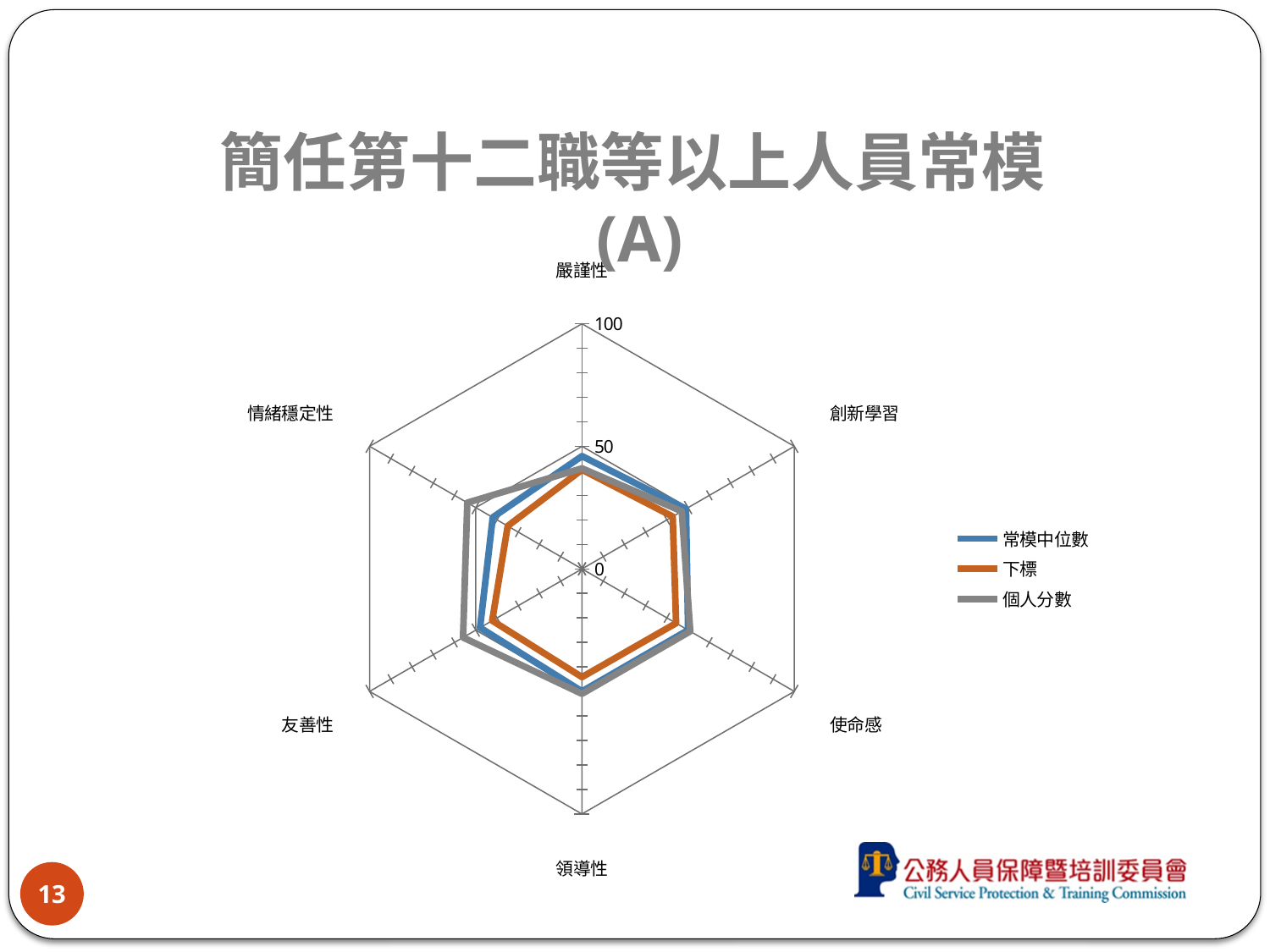
Is the value of 下標 for 友善性 greater or less than 50? less Which series is drawn in orange according to the legend? 下標 How many series does the legend list? 3 What is the title of the chart on the slide? 簡任第十二職等以上人員常模(A) Which series has the lowest value for 友善性? 下標 Is the value of 下標 for 情緒穩定性 greater or less than 50? less What kind of chart is shown on the slide? radar chart How many categories (axes) does the radar chart have? 6 For 情緒穩定性, which is larger: 個人分數 or 下標? 個人分數 For 友善性, which is larger: 個人分數 or 下標? 個人分數 Is the value of 下標 for 嚴謹性 greater or less than 50? less For 嚴謹性, which is larger: 常模中位數 or 下標? 常模中位數